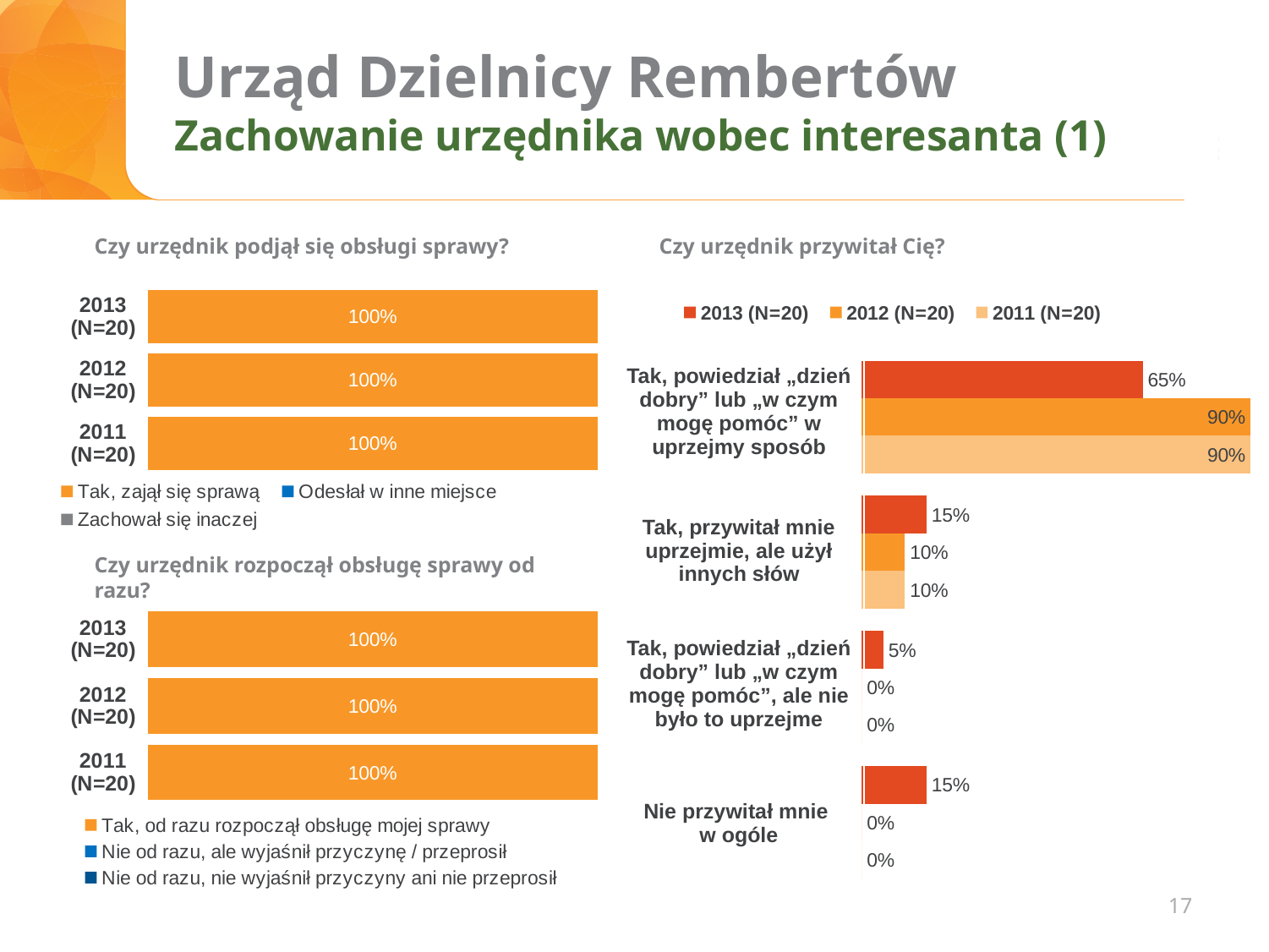
In the chart "Czy urzędnik przywitał Cię?", what is the value for 2013 (N=20) in the category "Tak, powiedział „dzień dobry” lub „w czym mogę pomóc” w uprzejmy sposób"? 65% In the chart "Czy urzędnik przywitał Cię?", how many categories are shown? 4 In the chart "Czy urzędnik przywitał Cię?", what is the value for 2012 (N=20) in the category "Tak, powiedział „dzień dobry” lub „w czym mogę pomóc” w uprzejmy sposób"? 90% In the chart "Czy urzędnik rozpoczął obsługę sprawy od razu?", what is the value for 2011 (N=20)? 100% In the chart "Czy urzędnik podjął się obsługi sprawy?", what is the value for 2012 (N=20)? 100% In the chart "Czy urzędnik przywitał Cię?", how many series does the legend list? 3 What type of chart is "Czy urzędnik przywitał Cię?"? Bar chart In the chart "Czy urzędnik przywitał Cię?", which is larger for "Tak, przywitał mnie uprzejmie, ale użył innych słów": the 2013 (N=20) value or the 2012 (N=20) value? 2013 (N=20) In the chart "Czy urzędnik przywitał Cię?", what is the difference between the 2012 (N=20) and 2013 (N=20) values for "Tak, powiedział „dzień dobry” lub „w czym mogę pomóc” w uprzejmy sposób"? 25% In the chart "Czy urzędnik przywitał Cię?", what is the value for 2013 (N=20) in the category "Nie przywitał mnie w ogóle"? 15% In the chart "Czy urzędnik przywitał Cię?", which category has the highest value for 2013 (N=20)? Tak, powiedział „dzień dobry” lub „w czym mogę pomóc” w uprzejmy sposób In the chart "Czy urzędnik przywitał Cię?", what is the value for 2011 (N=20) in the category "Tak, przywitał mnie uprzejmie, ale użył innych słów"? 10%